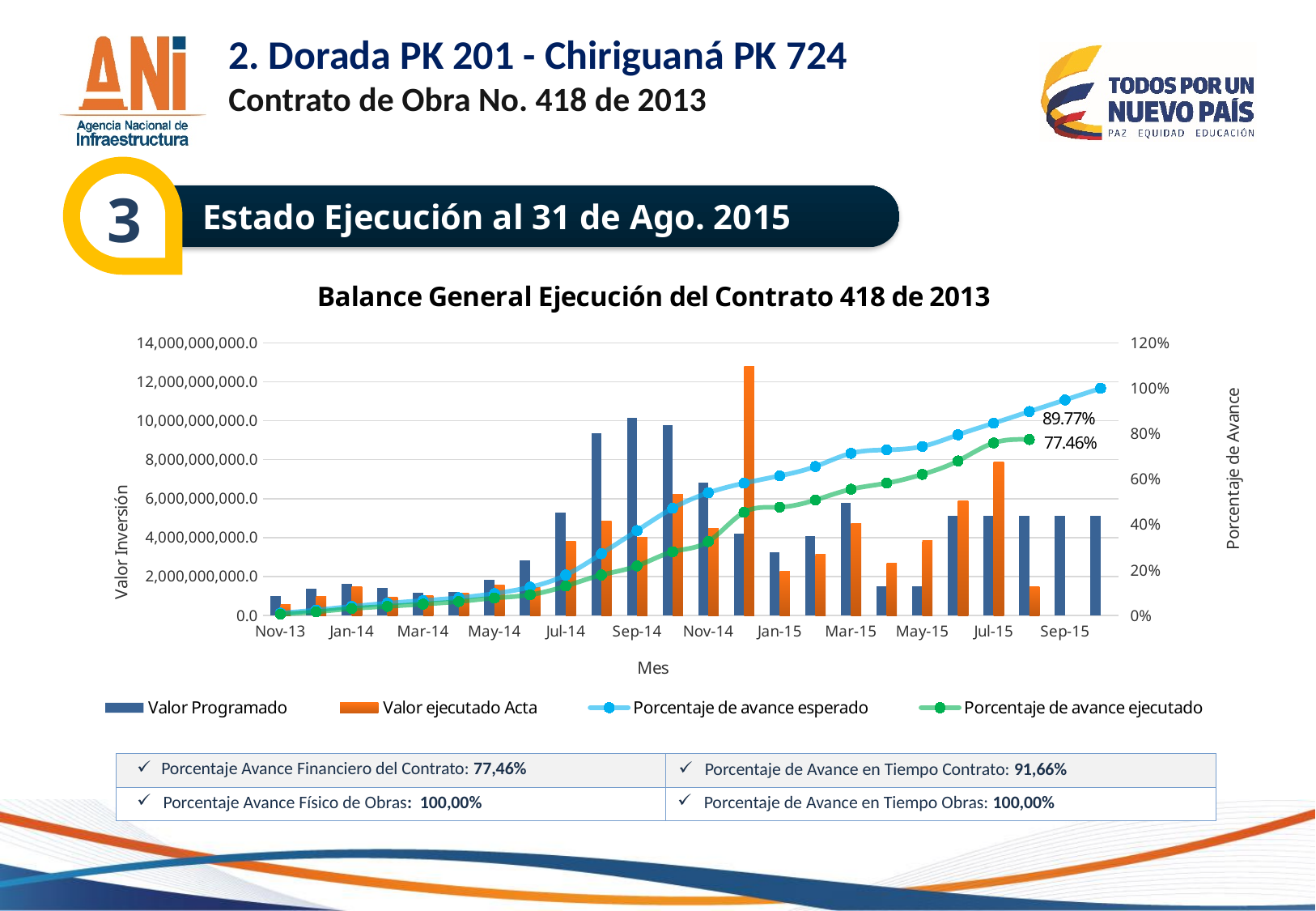
What is the title of the chart? Balance General Ejecución del Contrato 418 de 2013 Is the Valor ejecutado Acta bar for Jul-15 greater or less than 6,000,000,000.0? greater What is the final labelled value of the Porcentaje de avance ejecutado line? 77.46% What is the label of the left vertical axis? Valor Inversión What kind of chart is shown on the slide? Combined bar and line chart How many series does the chart legend list? 4 Is the Porcentaje de avance esperado value at Sep-15 greater or less than 80%? greater What is the difference between the final labelled values of Porcentaje de avance esperado (89.77%) and Porcentaje de avance ejecutado (77.46%)? 12.31% Does the Porcentaje de avance esperado line rise or fall from Nov-13 to Sep-15? rise What is the final labelled value of the Porcentaje de avance esperado line? 89.77% At the end of the series, which is higher: Porcentaje de avance esperado or Porcentaje de avance ejecutado? Porcentaje de avance esperado Is the Valor Programado bar for Sep-14 greater or less than 8,000,000,000.0? greater